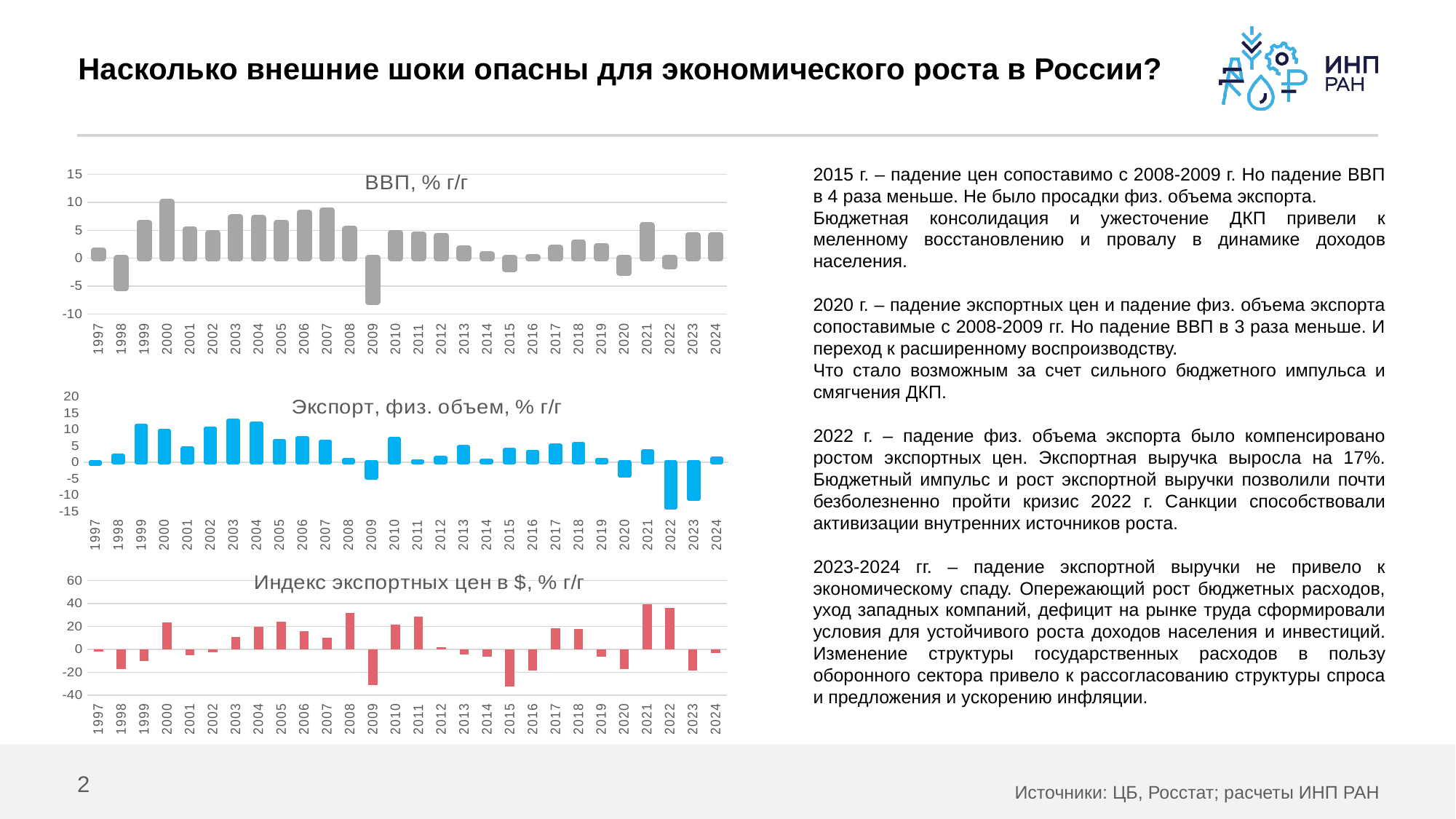
In the chart "ВВП, % г/г", is the value for 2009 greater or less than -5? less How many charts are shown on the slide? 3 In the chart "Экспорт, физ. объем, % г/г", which year has the lowest value? 2022 In the chart "ВВП, % г/г", which year has the lowest value? 2009 In the chart "Экспорт, физ. объем, % г/г", which is larger, the value for 2021 or the value for 2022? 2021 What is the title of the bottom chart on the slide? Индекс экспортных цен в $, % г/г In the chart "ВВП, % г/г", how many years are plotted along the x axis? 28 What kind of chart is the top chart titled "ВВП, % г/г"? bar chart In the chart "Индекс экспортных цен в $, % г/г", is the value for 2008 greater or less than 20? greater In the chart "Индекс экспортных цен в $, % г/г", which is larger, the value for 2007 or the value for 2008? 2008 In the chart "ВВП, % г/г", which year has the highest value? 2000 In the chart "Экспорт, физ. объем, % г/г", is the value for 2022 greater or less than -10? less